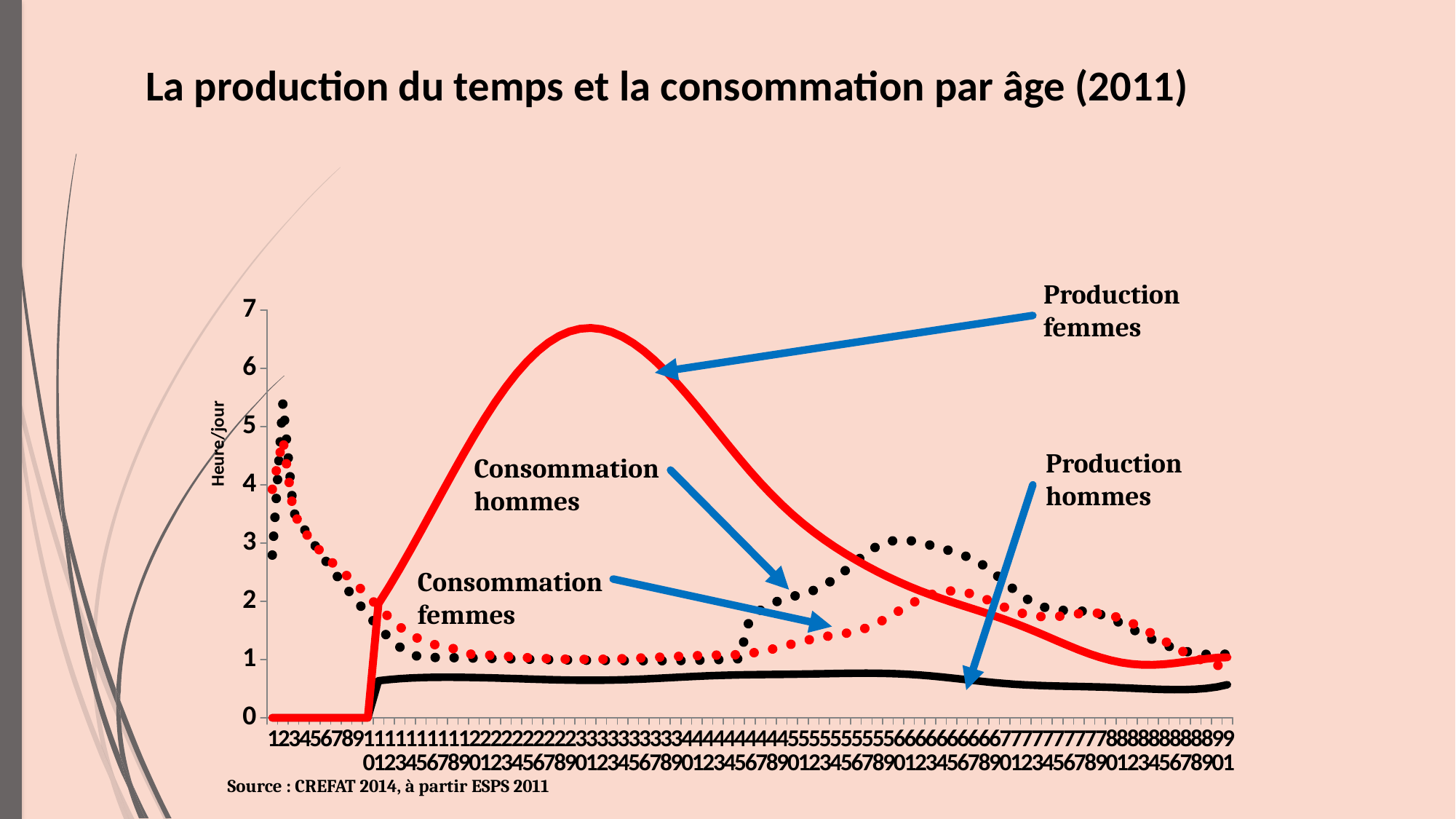
Is the peak value of Production femmes greater or less than 6? greater How many series are labelled on the chart? 4 Does Production femmes rise or fall between age 30 and age 90? fall Which series reaches the highest value on the chart? Production femmes What kind of chart is shown on the slide? line chart Around age 30, which is higher: Production femmes or Production hommes? Production femmes Is the highest value of Production hommes greater or less than 1? less Is the peak value of Consommation hommes (around age 60) greater or less than 2? greater What source is cited below the chart? CREFAT 2014, à partir ESPS 2011 Around age 60, which is higher: Consommation hommes or Consommation femmes? Consommation hommes What is the label of the vertical axis? Heure/jour What is the value of Production femmes at age 1? 0